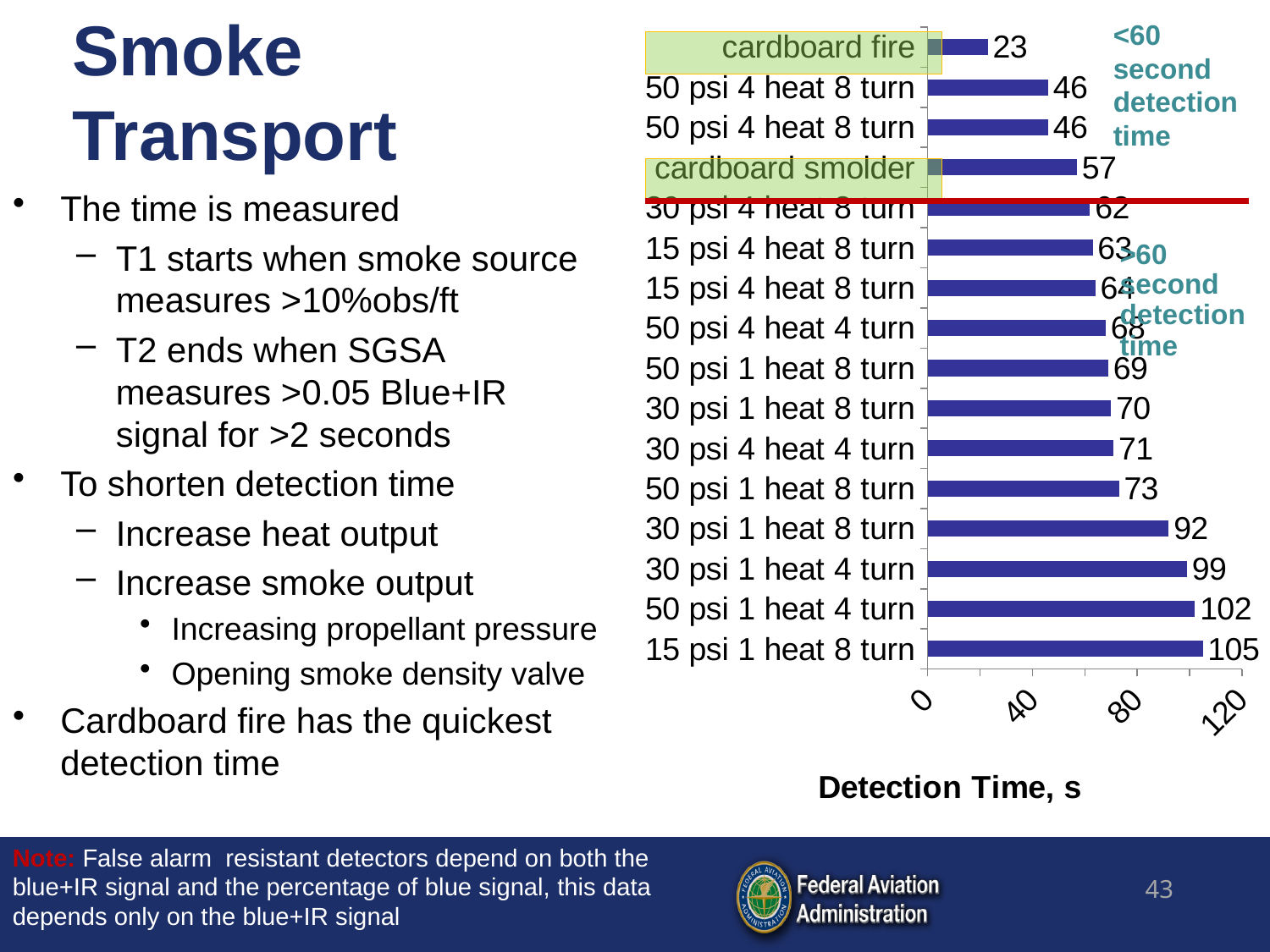
Which has a longer detection time, 50 psi 1 heat 4 turn or 30 psi 1 heat 4 turn? 50 psi 1 heat 4 turn What type of chart is shown on the slide? bar chart What is the detection time for cardboard smolder? 57 What is the detection time for 15 psi 1 heat 8 turn? 105 What is the detection time for cardboard fire? 23 What is the title of the horizontal axis of the chart? Detection Time, s Which category has the longest detection time? 15 psi 1 heat 8 turn What is the difference between the longest detection time (15 psi 1 heat 8 turn) and the shortest (cardboard fire)? 82 What is the difference in detection time between cardboard smolder and cardboard fire? 34 What is the detection time for 30 psi 4 heat 4 turn? 71 How many bars are plotted in the chart? 16 Which category has the shortest detection time? cardboard fire